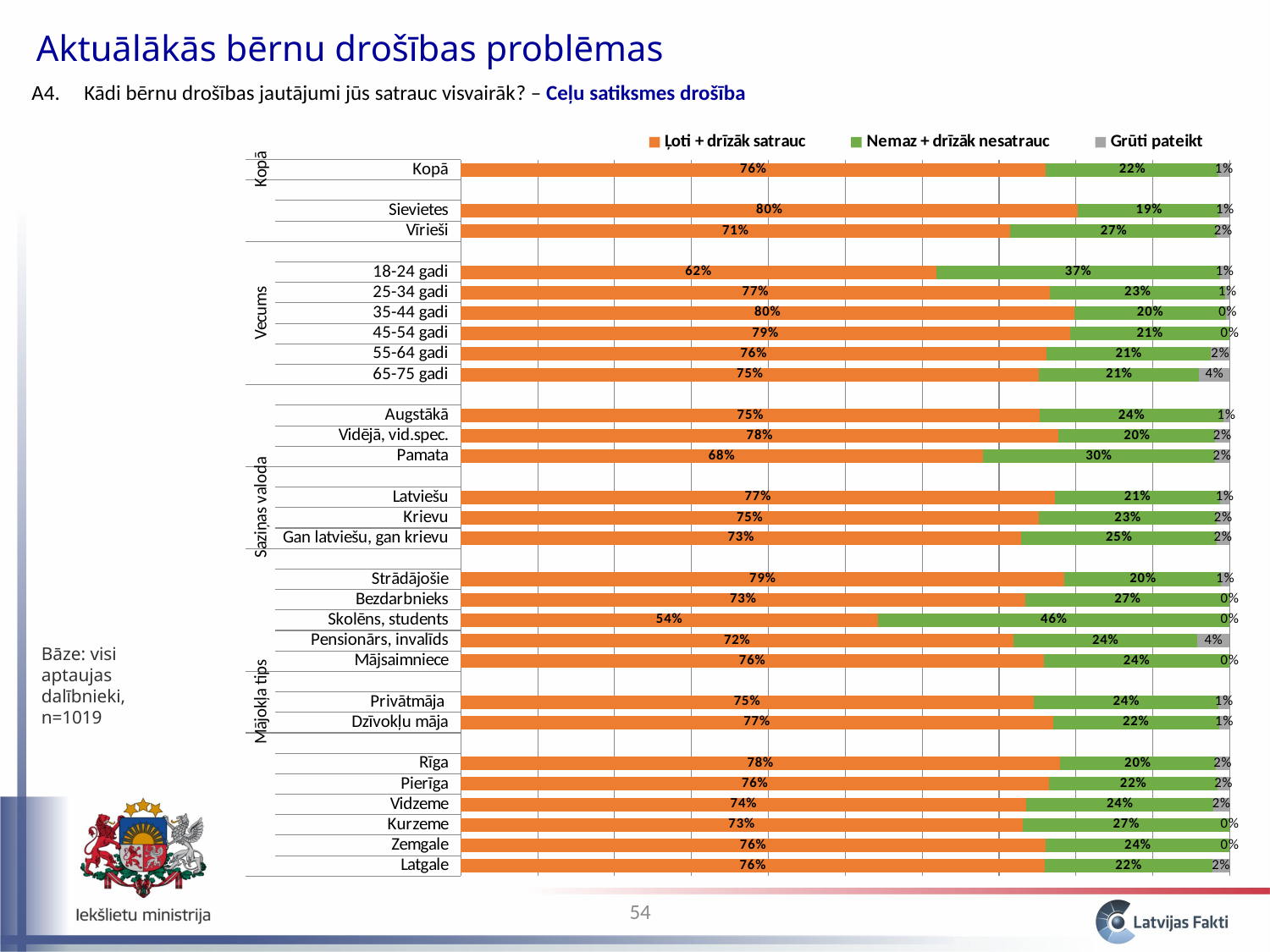
What kind of chart is shown on the slide? Stacked bar chart Which category has the highest 'Nemaz + drīzāk nesatrauc' value? Skolēns, students What is the 'Grūti pateikt' value for '65-75 gadi'? 4% Which has a larger 'Nemaz + drīzāk nesatrauc' value, 'Pamata' or 'Augstākā'? Pamata What is the total of the stacked bar for 'Pensionārs, invalīds'? 100% What is the 'Nemaz + drīzāk nesatrauc' value for 'Skolēns, students'? 46% How many categories are plotted in the chart? 28 What percentage of the 'Kopā' bar is 'Ļoti + drīzāk satrauc'? 76% How many series does the legend list? 3 Which category has the lowest 'Ļoti + drīzāk satrauc' value? Skolēns, students Which has a larger 'Ļoti + drīzāk satrauc' value, '18-24 gadi' or '25-34 gadi'? 25-34 gadi What is the difference between the 'Ļoti + drīzāk satrauc' values for 'Sievietes' and 'Vīrieši'? 9%